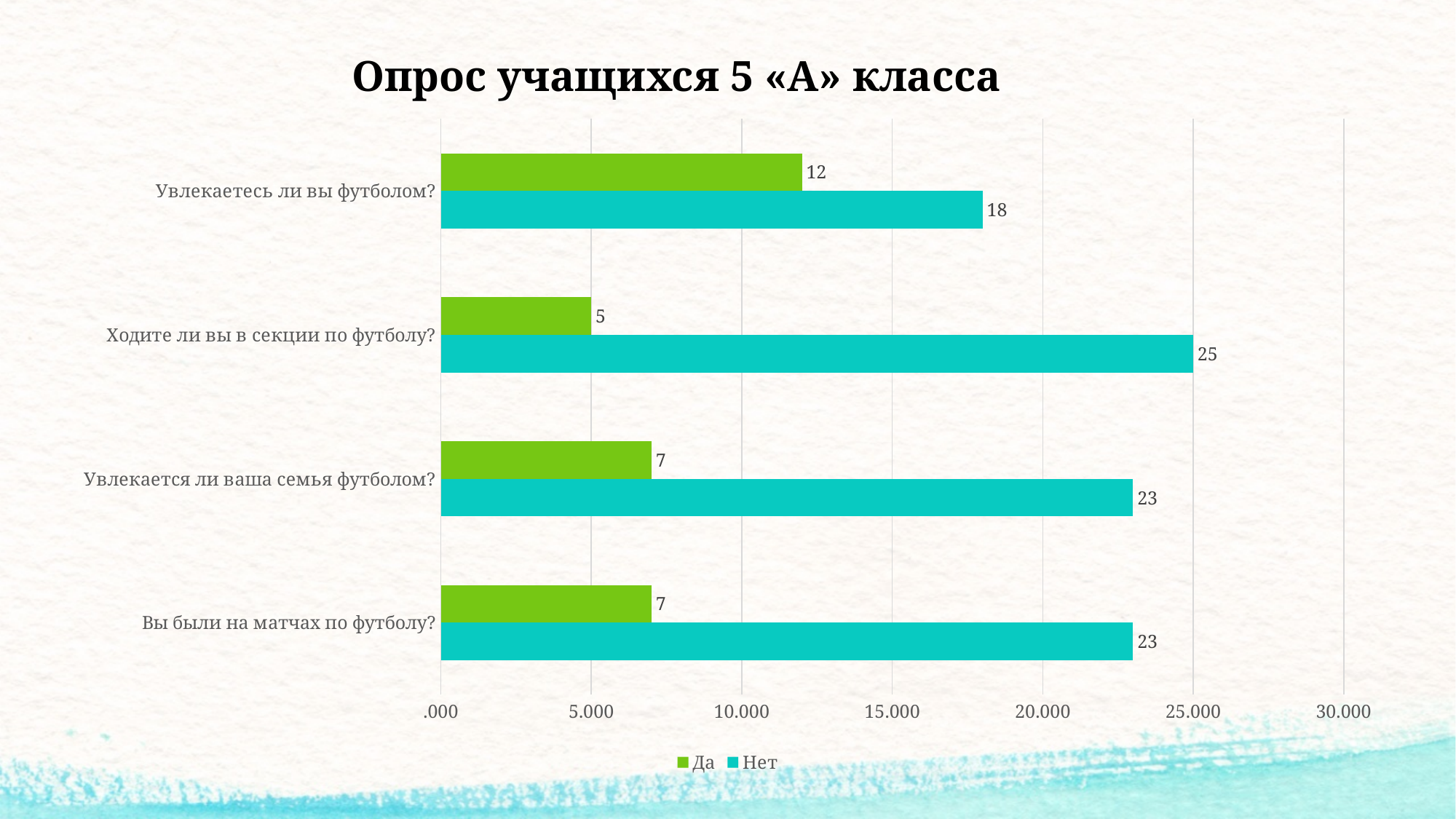
What is the value for "Нет" for "Ходите ли вы в секции по футболу?"? 25 What is the value for "Да" for "Увлекаетесь ли вы футболом?"? 12 What is the difference between the "Нет" and "Да" values for "Ходите ли вы в секции по футболу?"? 20 How many series does the legend list? 2 Which category has the highest "Нет" value? Ходите ли вы в секции по футболу? Which category has the lowest "Да" value? Ходите ли вы в секции по футболу? Which category has the highest "Да" value? Увлекаетесь ли вы футболом? What is the value for "Да" for "Увлекается ли ваша семья футболом?"? 7 For "Увлекаетесь ли вы футболом?", which is larger, "Да" or "Нет"? Нет What is the value for "Нет" for "Вы были на матчах по футболу?"? 23 What kind of chart is shown on the slide? Bar chart How many categories (questions) are shown on the chart? 4